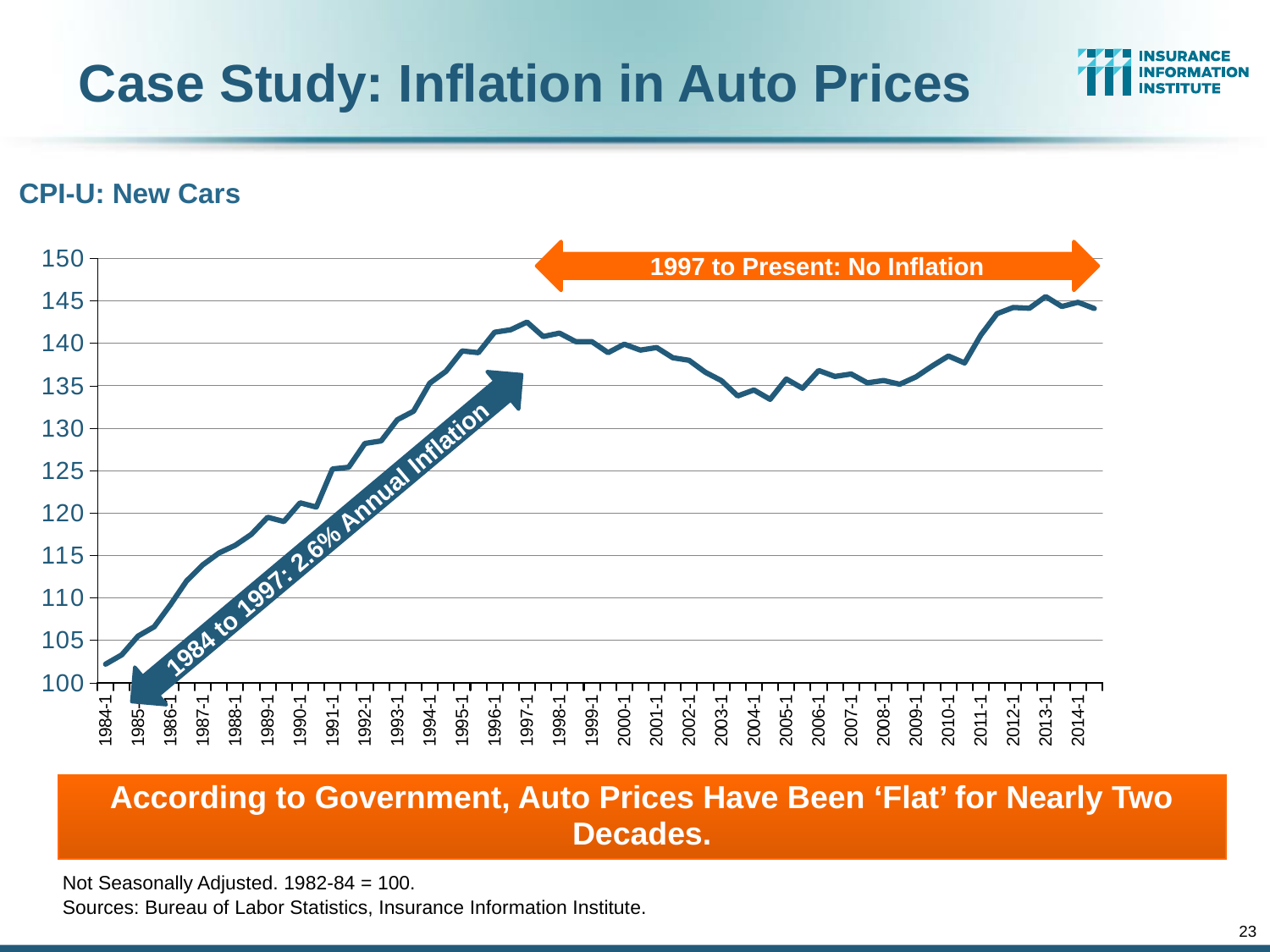
What is the highest value shown on the y axis? 150 Which is larger, the value for 2012-1 or the value for 2004-1? 2012-1 Is the value for 1992-1 greater or less than 125? greater Is the value for 1984-1 greater or less than 105? less Do the values rise or fall along the x axis from 1984-1 to 1997-1? rise What is the title of the chart? CPI-U: New Cars Is the value for 2002-1 greater or less than 140? less What annual inflation rate does the chart annotation give for 1984 to 1997? 2.6% How many year labels are shown on the x axis? 31 What kind of chart is shown on the slide? line chart